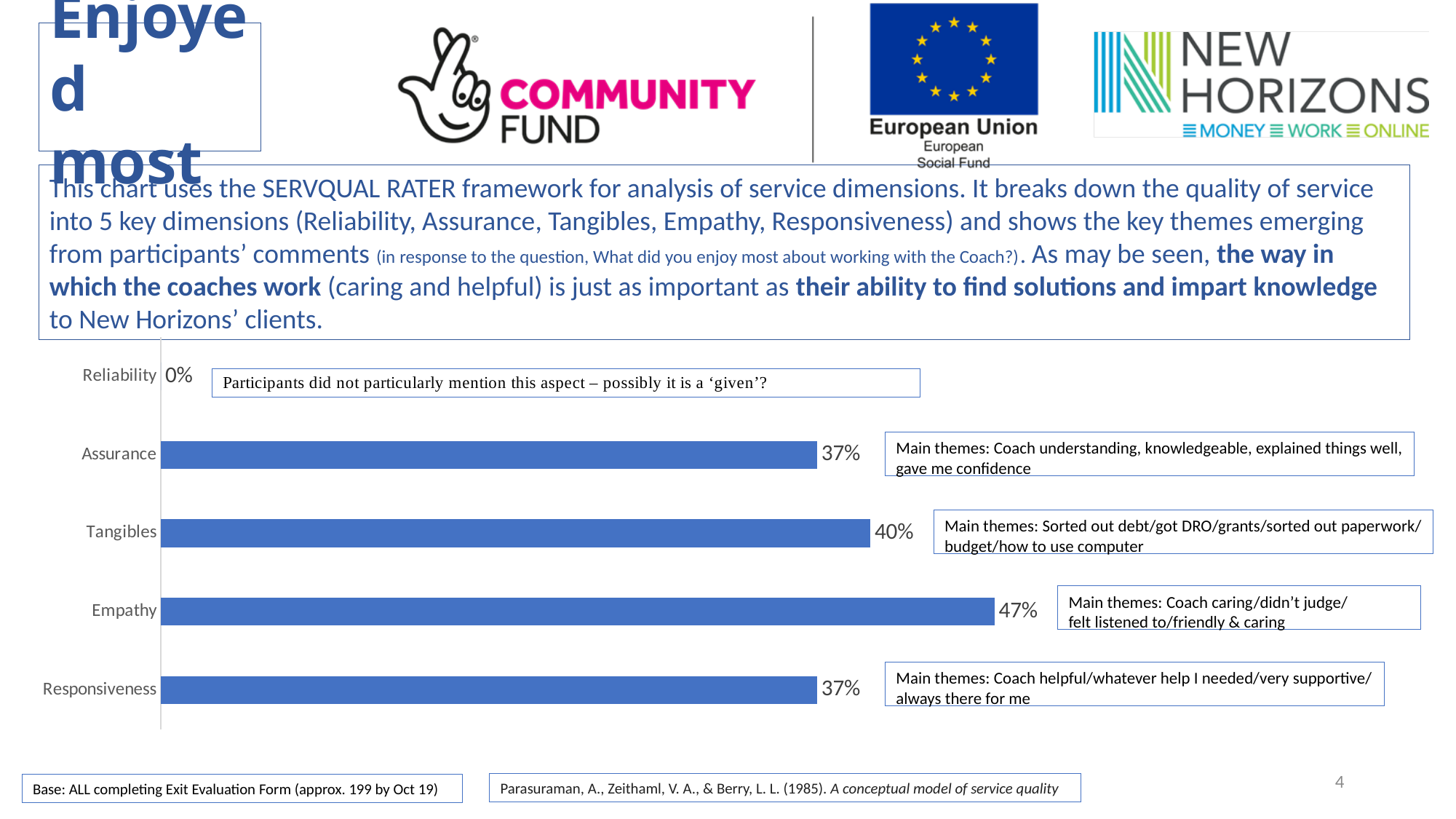
What colour are the bars in the chart? Blue What is the difference between the values for Empathy and Tangibles? 7% What is the value for Empathy? 47% How many categories are shown in the chart? 5 Which category has the highest value? Empathy Which category has the lowest value? Reliability Which is larger, the value for Empathy or the value for Assurance? Empathy What kind of chart is shown on the slide? Bar chart What is the value for Assurance? 37% What is the value for Tangibles? 40% What is the value for Reliability? 0% What is the difference between the values for Tangibles and Responsiveness? 3%